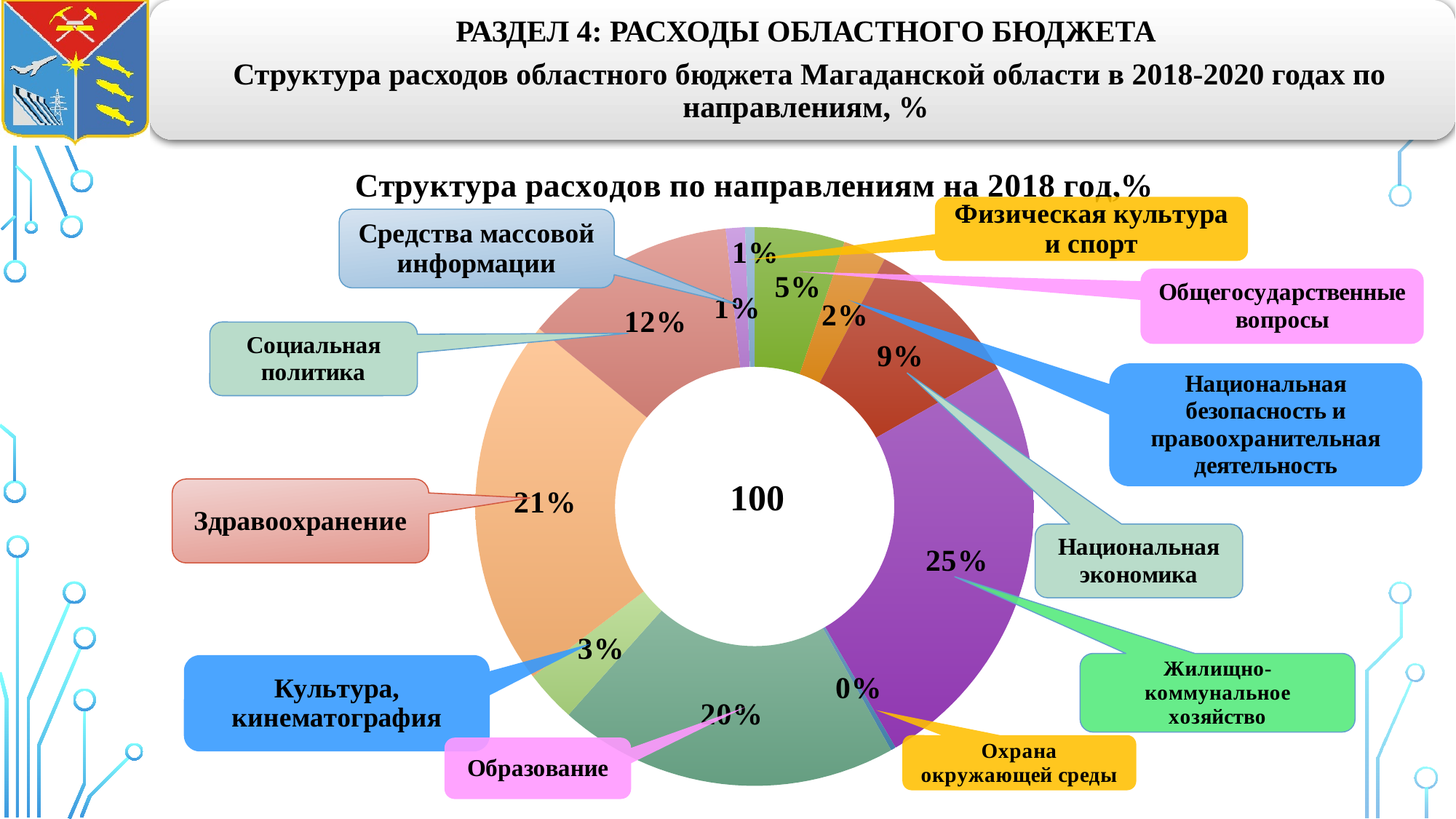
What is the title of the chart on the slide? Структура расходов по направлениям на 2018 год,% What kind of chart is shown on the slide? doughnut (pie) chart What percentage is shown for Здравоохранение? 21% Which is larger, the share for Здравоохранение or for Социальная политика? Здравоохранение What percentage is shown for Охрана окружающей среды? 0% What percentage is shown for Культура, кинематография? 3% Which category has the smallest share in the chart? Охрана окружающей среды What percentage is shown for Социальная политика? 12% What percentage is shown for Образование? 20% What is the difference in percentage points between Здравоохранение and Образование? 1 What is the largest percentage value labelled on the chart? 25% What percentage is shown for Средства массовой информации? 1%